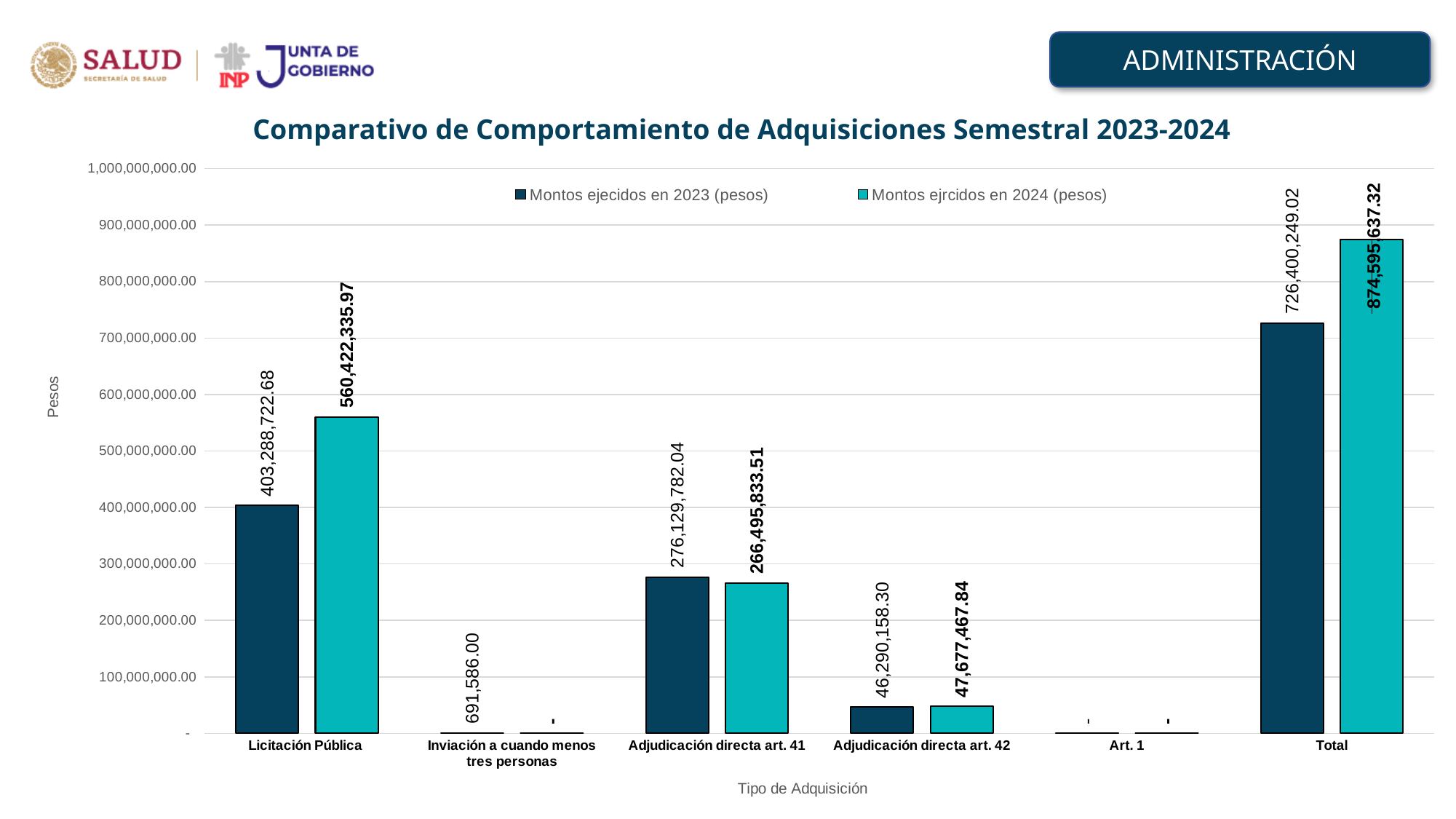
Which category has the highest value for Montos ejrcidos en 2024 (pesos)? Total What is the value of Montos ejrcidos en 2024 (pesos) for Total? 874,595,637.32 What type of chart is shown on the slide? Bar chart What is the value of Montos ejecidos en 2023 (pesos) for Licitación Pública? 403,288,722.68 How many categories are shown on the x axis? 6 What is the difference between the 2024 and 2023 values for Licitación Pública? 157,133,613.29 For Adjudicación directa art. 41, which is larger: the 2023 value or the 2024 value? The 2023 value What is the value of Montos ejecidos en 2023 (pesos) for Inviación a cuando menos tres personas? 691,586.00 Is the value of Montos ejrcidos en 2024 (pesos) for Total greater or less than 800,000,000.00? greater How many series does the legend list? 2 What is the value of Montos ejrcidos en 2024 (pesos) for Licitación Pública? 560,422,335.97 What is the value of Montos ejecidos en 2023 (pesos) for Adjudicación directa art. 42? 46,290,158.30